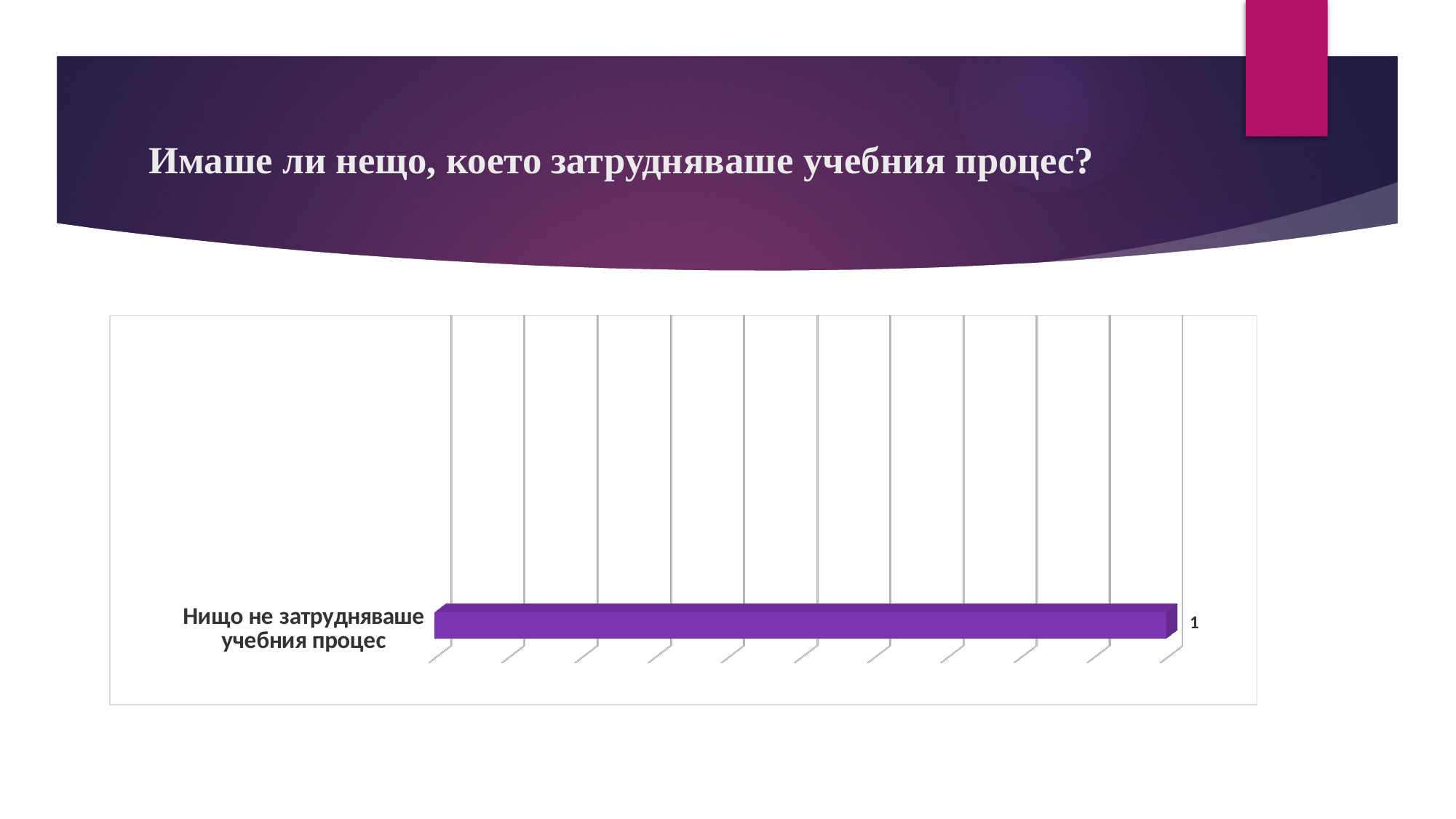
What kind of chart is shown on the slide? bar chart How many categories does the chart show? 1 What colour is the bar in the chart? purple What is the value for "Нищо не затрудняваше учебния процес"? 1 Are the bars in the chart horizontal or vertical? horizontal What is the label of the only category in the chart? Нищо не затрудняваше учебния процес